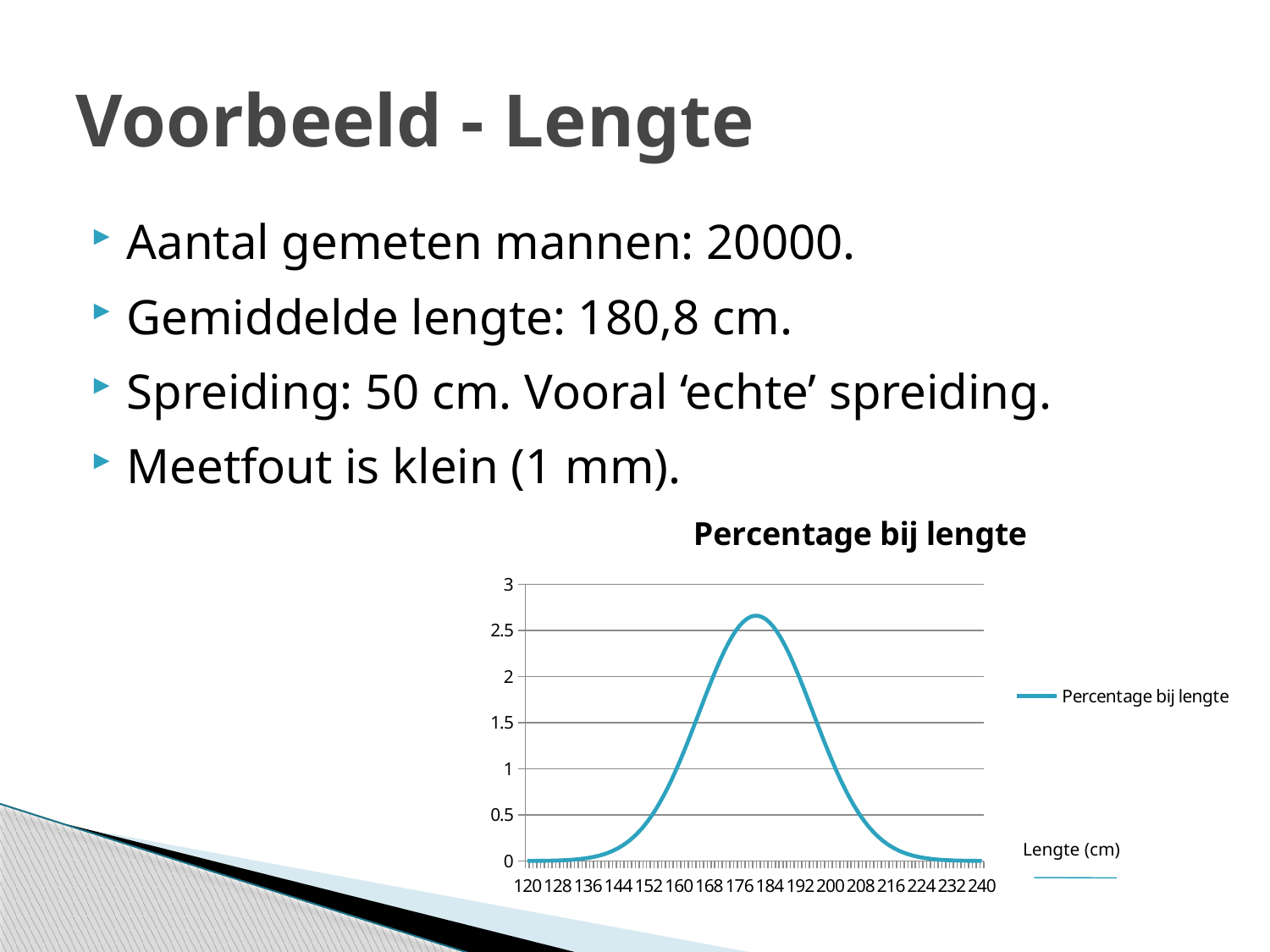
Is the value for 120 greater or less than 0.5? less Is the highest value of the curve greater or less than 2? greater How many series does the chart's legend list? 1 Is the value for 144 greater or less than 0.5? less Does the curve rise or fall as the length goes from 120 to 176? rise Does the curve rise or fall as the length goes from 192 to 240? fall What is the label of the x axis of the chart? Lengte (cm) What is the title of the chart? Percentage bij lengte What kind of chart is shown on the slide? line chart